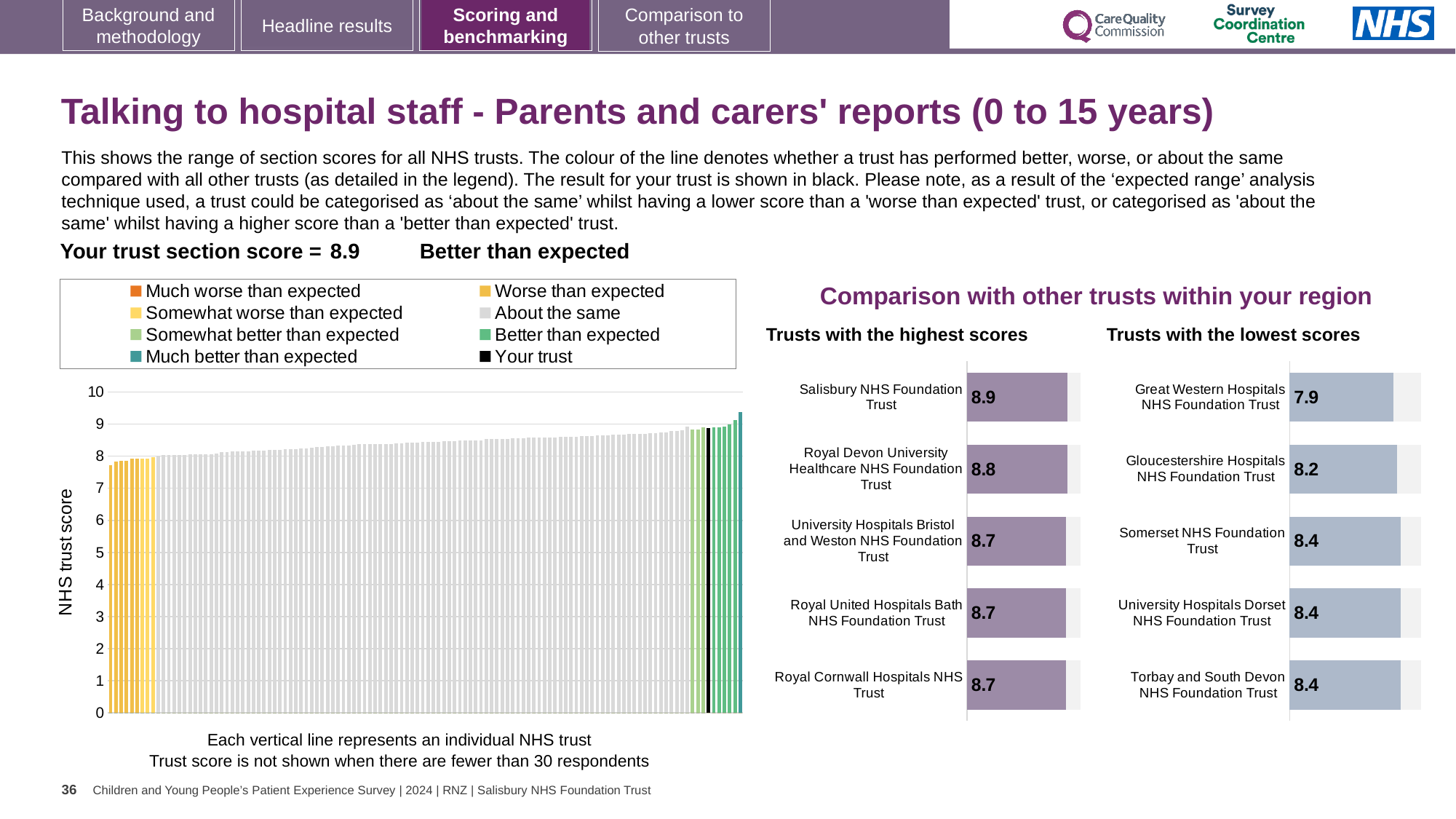
In the main chart on the left showing all NHS trusts, is the value for the black 'Your trust' bar greater or less than 8? greater In the 'Trusts with the lowest scores' chart, what is the difference between the scores of Gloucestershire Hospitals NHS Foundation Trust and Great Western Hospitals NHS Foundation Trust? 0.3 In the 'Trusts with the lowest scores' chart, what is the score for Gloucestershire Hospitals NHS Foundation Trust? 8.2 In the 'Trusts with the highest scores' chart, what is the score for Royal Devon University Healthcare NHS Foundation Trust? 8.8 In the 'Trusts with the lowest scores' chart, what is the score for Great Western Hospitals NHS Foundation Trust? 7.9 In the 'Trusts with the highest scores' chart, what is the difference between the scores of Salisbury NHS Foundation Trust and Royal Cornwall Hospitals NHS Trust? 0.2 In the 'Trusts with the highest scores' chart, which trust has the highest score? Salisbury NHS Foundation Trust In the 'Trusts with the lowest scores' chart, which trust has the lowest score? Great Western Hospitals NHS Foundation Trust Which has the higher score: Somerset NHS Foundation Trust in the 'Trusts with the lowest scores' chart or Royal United Hospitals Bath NHS Foundation Trust in the 'Trusts with the highest scores' chart? Royal United Hospitals Bath NHS Foundation Trust What kind of chart is the main chart on the left showing all NHS trusts? Bar chart In the 'Trusts with the highest scores' chart, what is the score for Salisbury NHS Foundation Trust? 8.9 How many trusts are shown in the 'Trusts with the highest scores' chart? 5